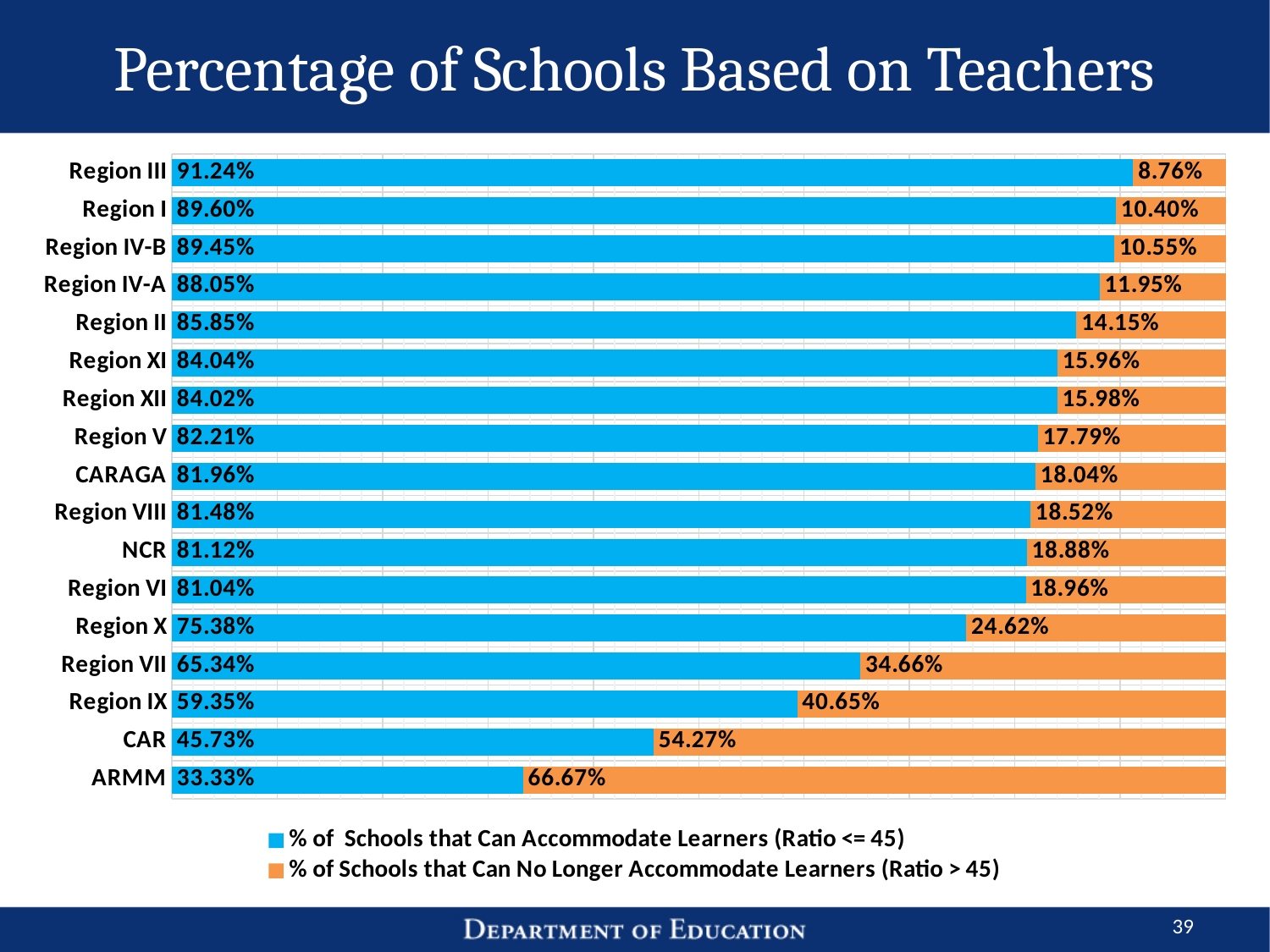
What is the total of the two segments for Region V? 100% Which has a higher percentage of schools that can accommodate learners (Ratio <= 45): Region X or NCR? NCR Which region has the highest percentage of schools that can no longer accommodate learners (Ratio > 45)? ARMM Which region has the highest percentage of schools that can accommodate learners (Ratio <= 45)? Region III Which region has the lowest percentage of schools that can accommodate learners (Ratio <= 45)? ARMM What is the difference between Region IX's and Region VII's percentages of schools that can no longer accommodate learners (Ratio > 45)? 5.99% What is the value for CAR in the '% of Schools that Can Accommodate Learners (Ratio <= 45)' series? 45.73% What percentage of schools in ARMM can no longer accommodate learners (Ratio > 45)? 66.67% What percentage of schools in Region III can accommodate learners (Ratio <= 45)? 91.24% What type of chart is shown on the slide? Stacked bar chart How many series does the legend list? 2 How many regions are shown in the chart? 17